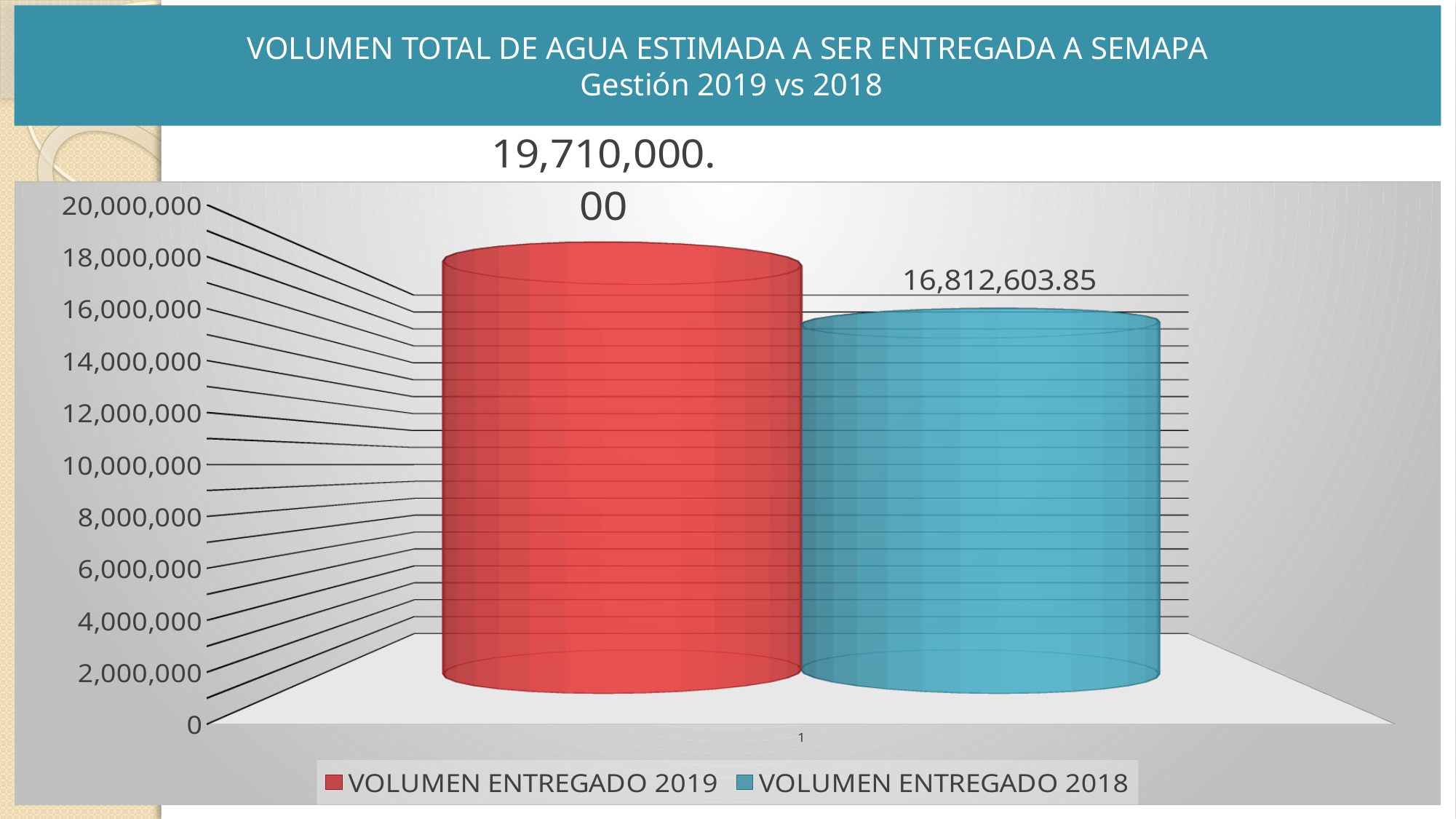
Which series has the highest value on the chart? VOLUMEN ENTREGADO 2019 How many series does the legend list? 2 Is the value for VOLUMEN ENTREGADO 2019 greater or less than 18,000,000? greater Which series has the higher value, VOLUMEN ENTREGADO 2019 or VOLUMEN ENTREGADO 2018? VOLUMEN ENTREGADO 2019 Is the value for VOLUMEN ENTREGADO 2018 greater or less than 18,000,000? less What is the value shown for VOLUMEN ENTREGADO 2018? 16,812,603.85 What is the difference between the 2019 volume and the 2018 volume? 2,897,396.15 What is the value shown for VOLUMEN ENTREGADO 2019? 19,710,000.00 What kind of chart is shown on the slide? Bar chart What colour is the bar for VOLUMEN ENTREGADO 2018? Blue Which series has the lowest value on the chart? VOLUMEN ENTREGADO 2018 What is the title of the chart? VOLUMEN TOTAL DE AGUA ESTIMADA A SER ENTREGADA A SEMAPA Gestión 2019 vs 2018